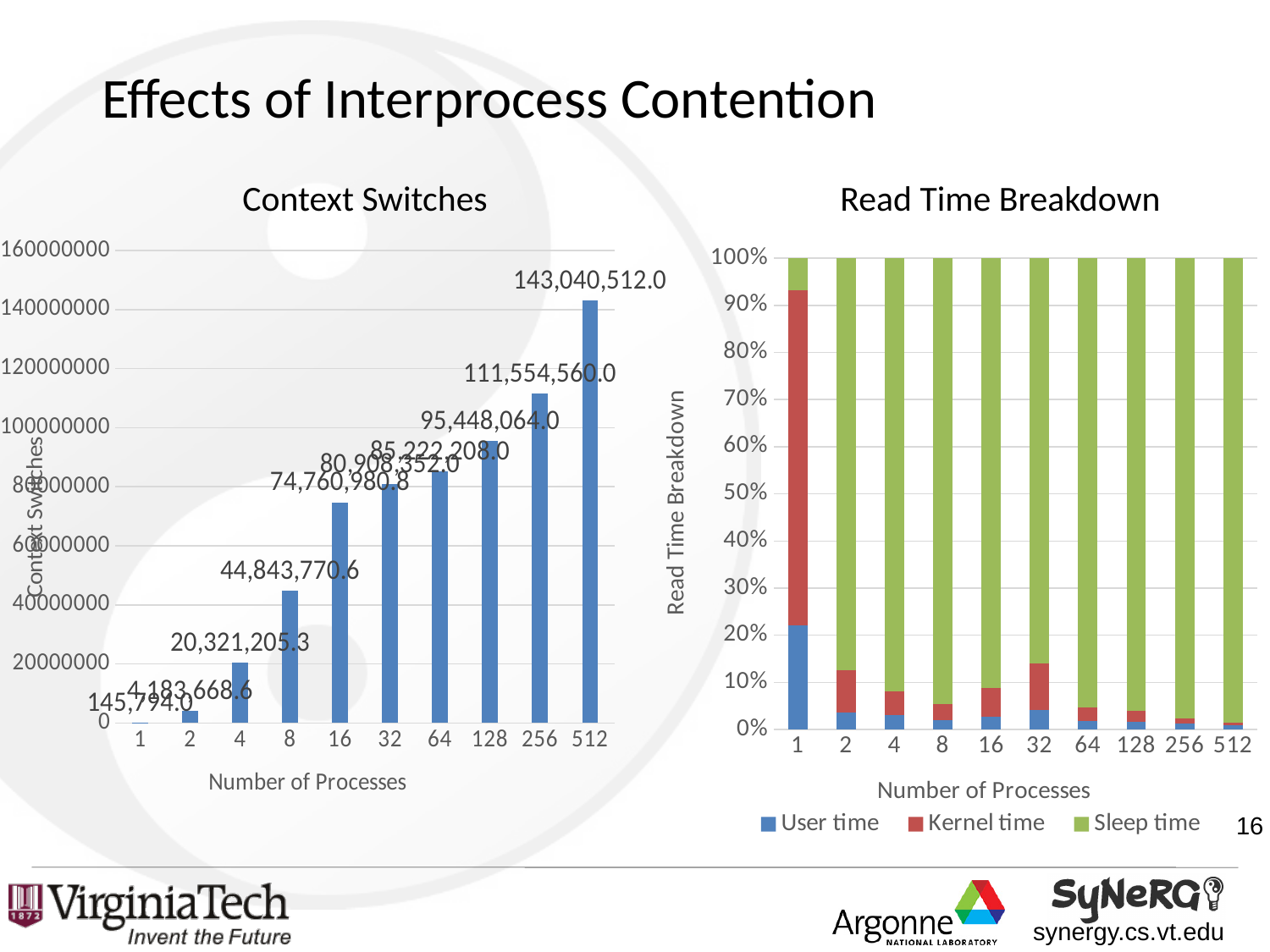
In the Context Switches chart, do the values rise or fall as the number of processes increases? rise In the Context Switches chart, what is the difference between the values for 512 and 256 processes? 31,485,952.0 In the Read Time Breakdown chart, is the Kernel time share for 1 process greater or less than 50%? greater In the Read Time Breakdown chart, how many series does the legend list? 3 In the Context Switches chart, what is the value for 8 processes? 44,843,770.6 In the Context Switches chart, which number of processes has the lowest value? 1 In the Context Switches chart, what is the value for 2 processes? 4,183,668.6 In the Context Switches chart, what is the value for 512 processes? 143,040,512.0 What kind of chart is the Context Switches chart? bar chart In the Context Switches chart, how many process counts are plotted along the x axis? 10 In the Read Time Breakdown chart, which has the larger Kernel time share: 1 process or 2 processes? 1 process In the Context Switches chart, which number of processes has the highest value? 512